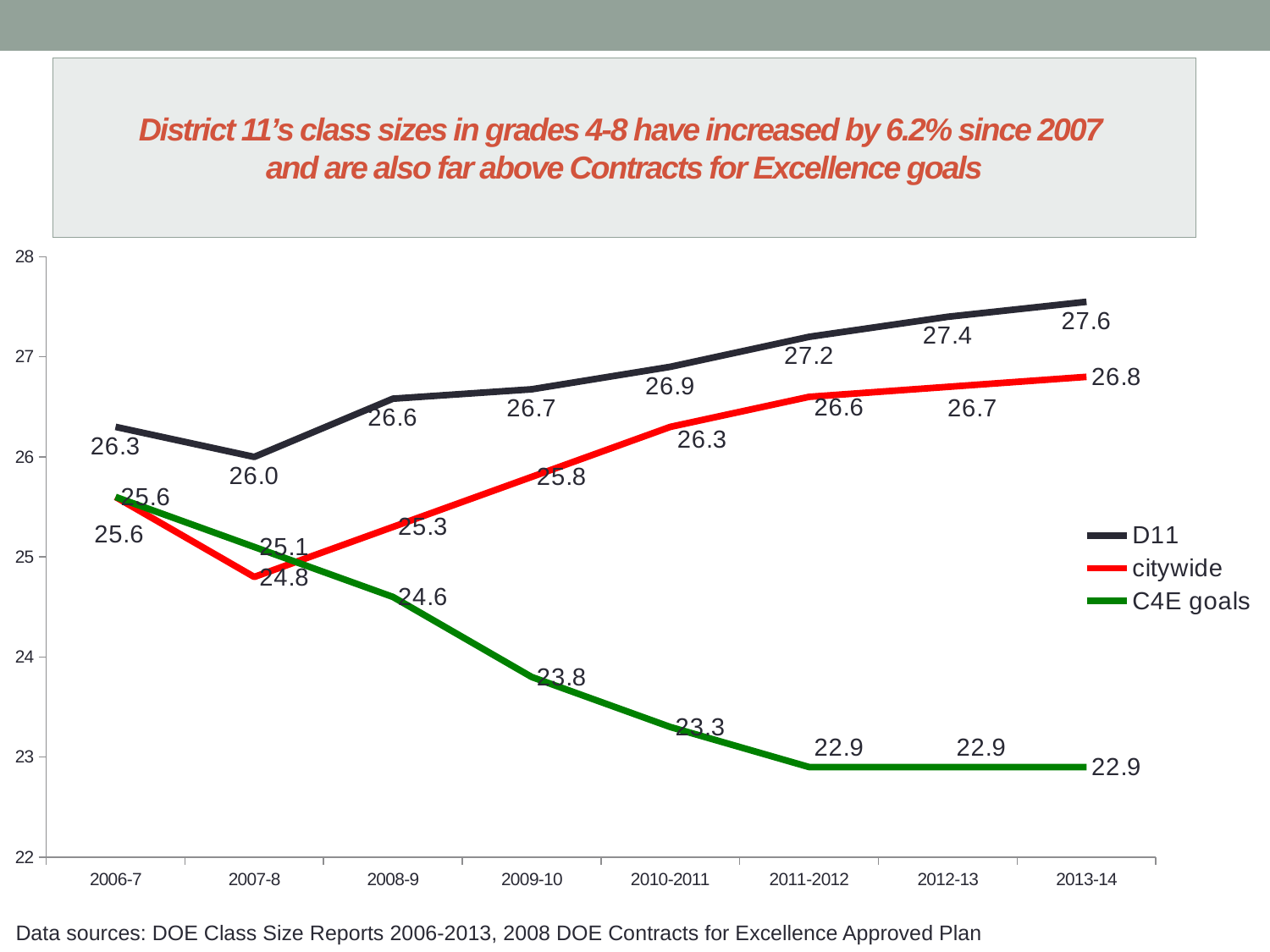
How many years are shown on the x axis? 8 How many series does the legend list? 3 What is the D11 class size value for 2013-14? 27.6 What is the difference between the D11 value and the C4E goals value in 2013-14? 4.7 What is the citywide value for 2007-8? 24.8 In which year is the D11 value highest? 2013-14 What kind of chart is shown on the slide? line chart By how much did the D11 value increase from 2006-7 to 2013-14? 1.3 What is the C4E goals value for 2009-10? 23.8 Do the C4E goals values rise or fall from 2006-7 to 2013-14? fall In which year is the citywide value lowest? 2007-8 Which is larger in 2010-2011, the D11 value or the citywide value? D11